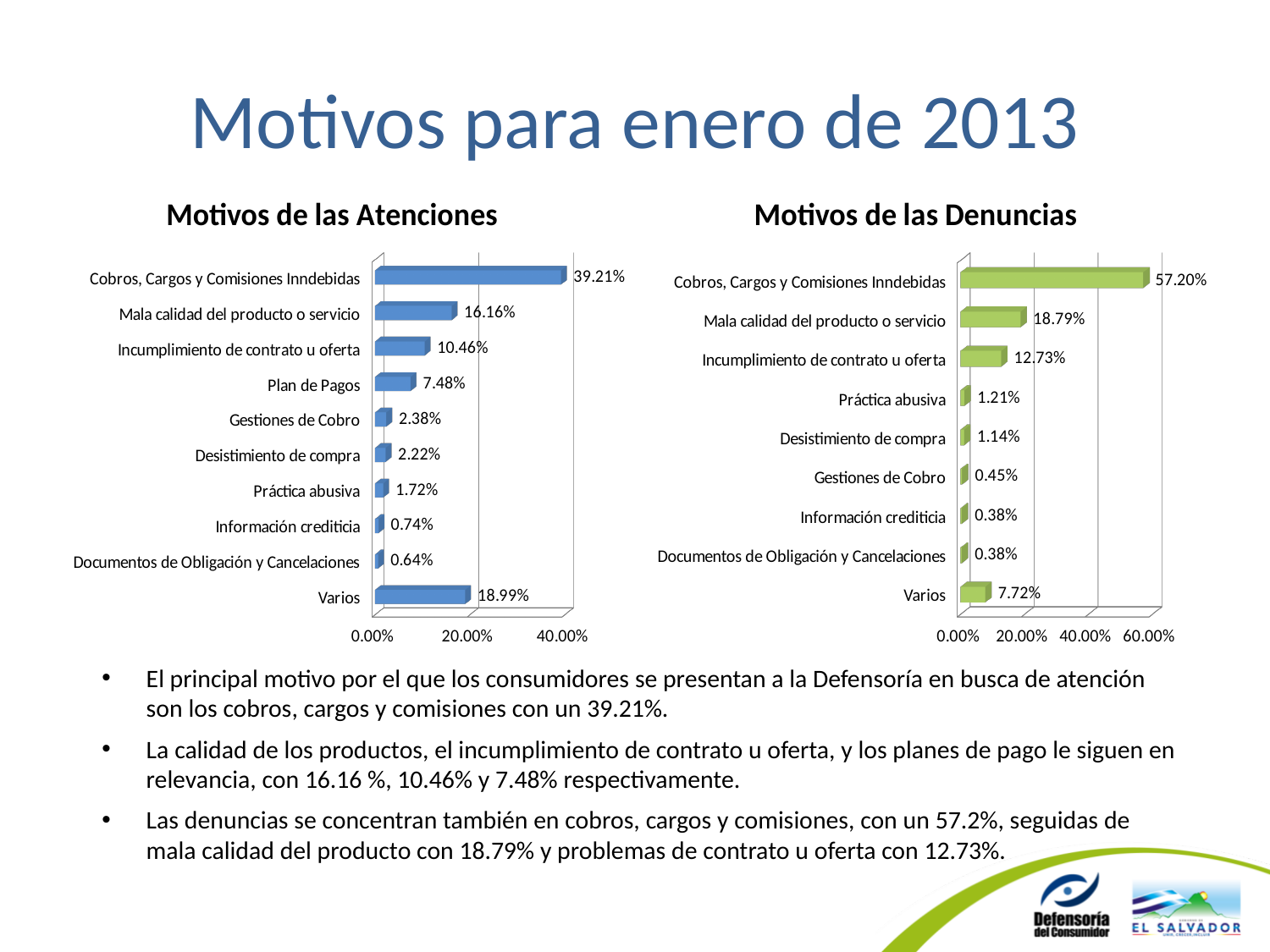
In the 'Motivos de las Atenciones' chart, which category has the highest value? Cobros, Cargos y Comisiones Inndebidas In the 'Motivos de las Atenciones' chart, which is larger: Varios or Mala calidad del producto o servicio? Varios What kind of chart is 'Motivos de las Denuncias'? Bar chart In the 'Motivos de las Denuncias' chart, what is the value for Mala calidad del producto o servicio? 18.79% What colour are the bars in the 'Motivos de las Denuncias' chart? Green In the 'Motivos de las Atenciones' chart, what is the value for Varios? 18.99% In the 'Motivos de las Denuncias' chart, what is the difference between Cobros, Cargos y Comisiones Inndebidas and Mala calidad del producto o servicio? 38.41% In the 'Motivos de las Atenciones' chart, what is the value for Plan de Pagos? 7.48% In the 'Motivos de las Atenciones' chart, which category has the lowest value? Documentos de Obligación y Cancelaciones In the 'Motivos de las Denuncias' chart, is the value for Cobros, Cargos y Comisiones Inndebidas greater or less than 40.00%? greater In the 'Motivos de las Denuncias' chart, which category has the highest value? Cobros, Cargos y Comisiones Inndebidas How many categories are shown in the 'Motivos de las Atenciones' chart? 10